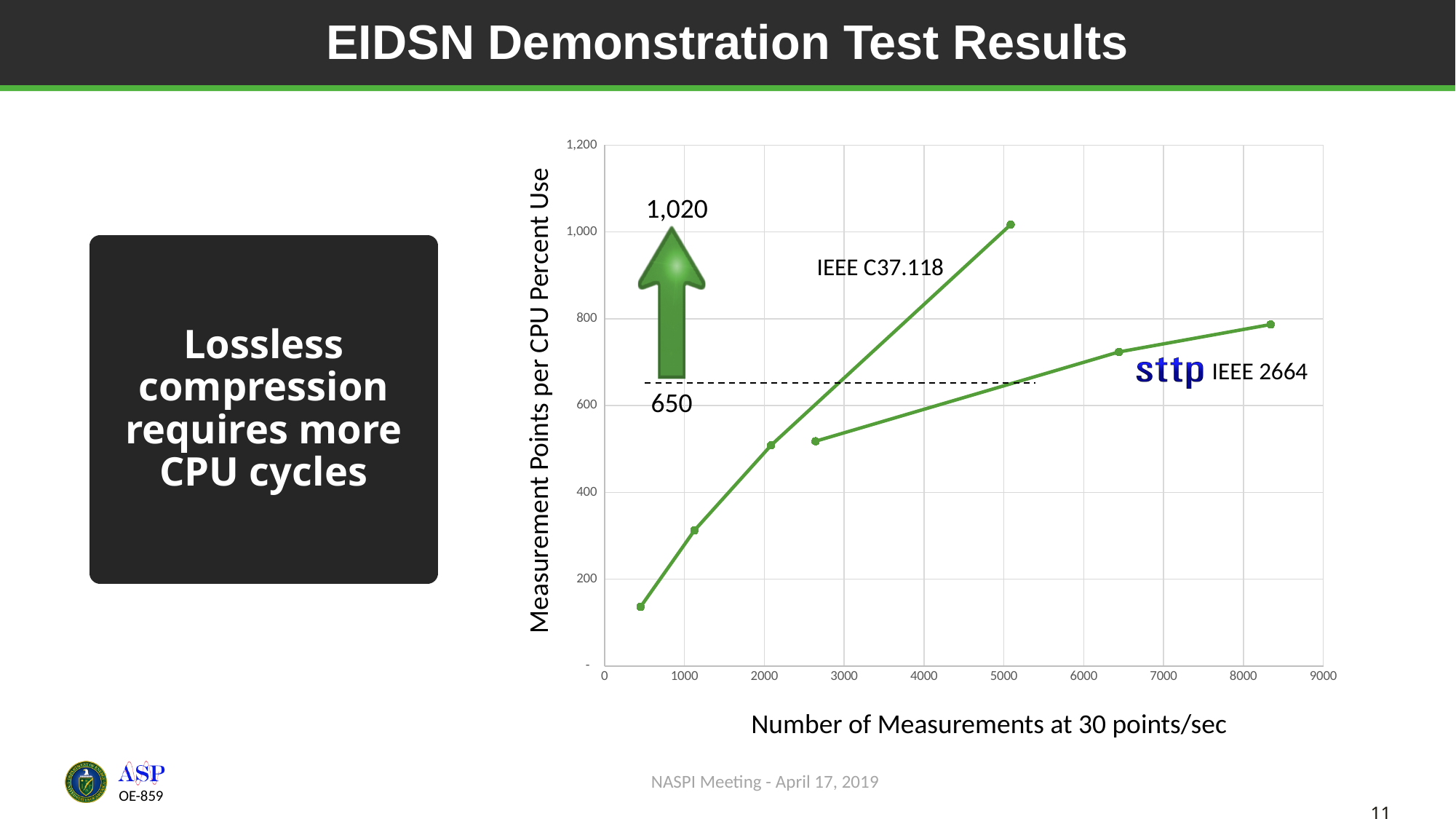
What value is annotated at the top of the IEEE C37.118 line? 1,020 How many data points are plotted on the IEEE C37.118 line? 4 Is the highest value of the IEEE C37.118 line greater or less than 800? greater What value is labelled on the dashed horizontal line? 650 How many data points are plotted on the sttp IEEE 2664 line? 3 Is the first (leftmost) point of the IEEE C37.118 line greater or less than 200? less Which series reaches the highest value on the chart? IEEE C37.118 What kind of chart is shown on the slide? line chart What is the title of the vertical axis? Measurement Points per CPU Percent Use Is the highest point of the sttp IEEE 2664 line greater or less than 600? greater Do the values of the sttp IEEE 2664 line rise or fall as the number of measurements increases? rise How many lines (series) are plotted on the chart? 2